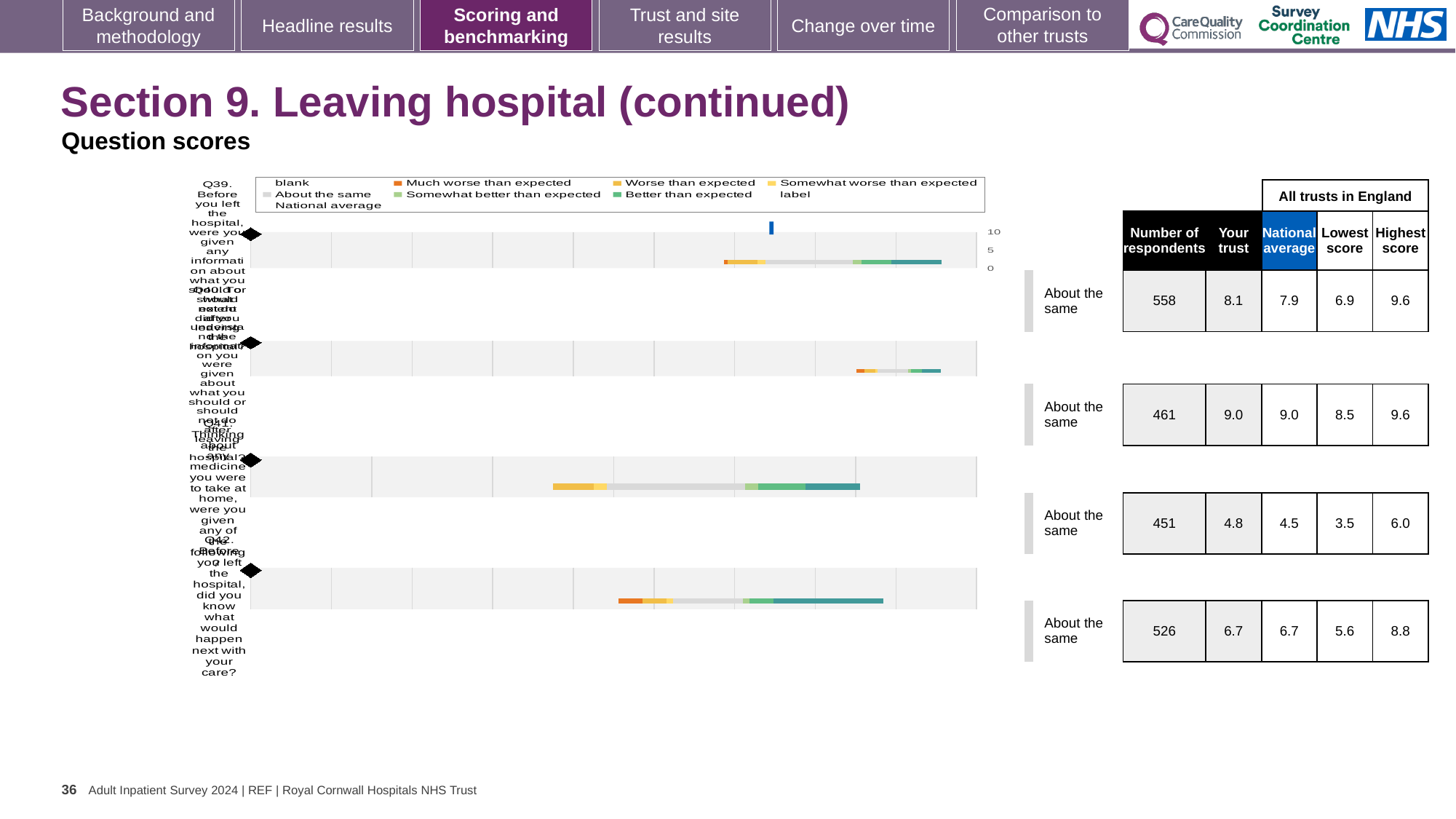
In the table beside the chart, which row has the lowest 'Lowest score' value? the third row (3.5) In the table beside the chart, what is the 'Your trust' score for the first row (Q39)? 8.1 In the table beside the chart, which is larger for the first row (Q39): the 'Your trust' score or the national average? Your trust In the table beside the chart, which row has the highest number of respondents? the first row (558) In the table beside the chart, what is the difference between the 'Your trust' score and the national average for the first row (Q39)? 0.2 How many question rows (diamond markers) does the chart show? 4 In the table beside the chart, what is the highest score for the third row? 6.0 What kind of chart is shown on the slide? bar chart In the table beside the chart, what is the national average for the first row (Q39)? 7.9 In the table beside the chart, what is the number of respondents for the first row (Q39)? 558 What benchmark label is shown next to every row of the chart? About the same In the table beside the chart, what is the 'Your trust' score for the last row (Q42)? 6.7